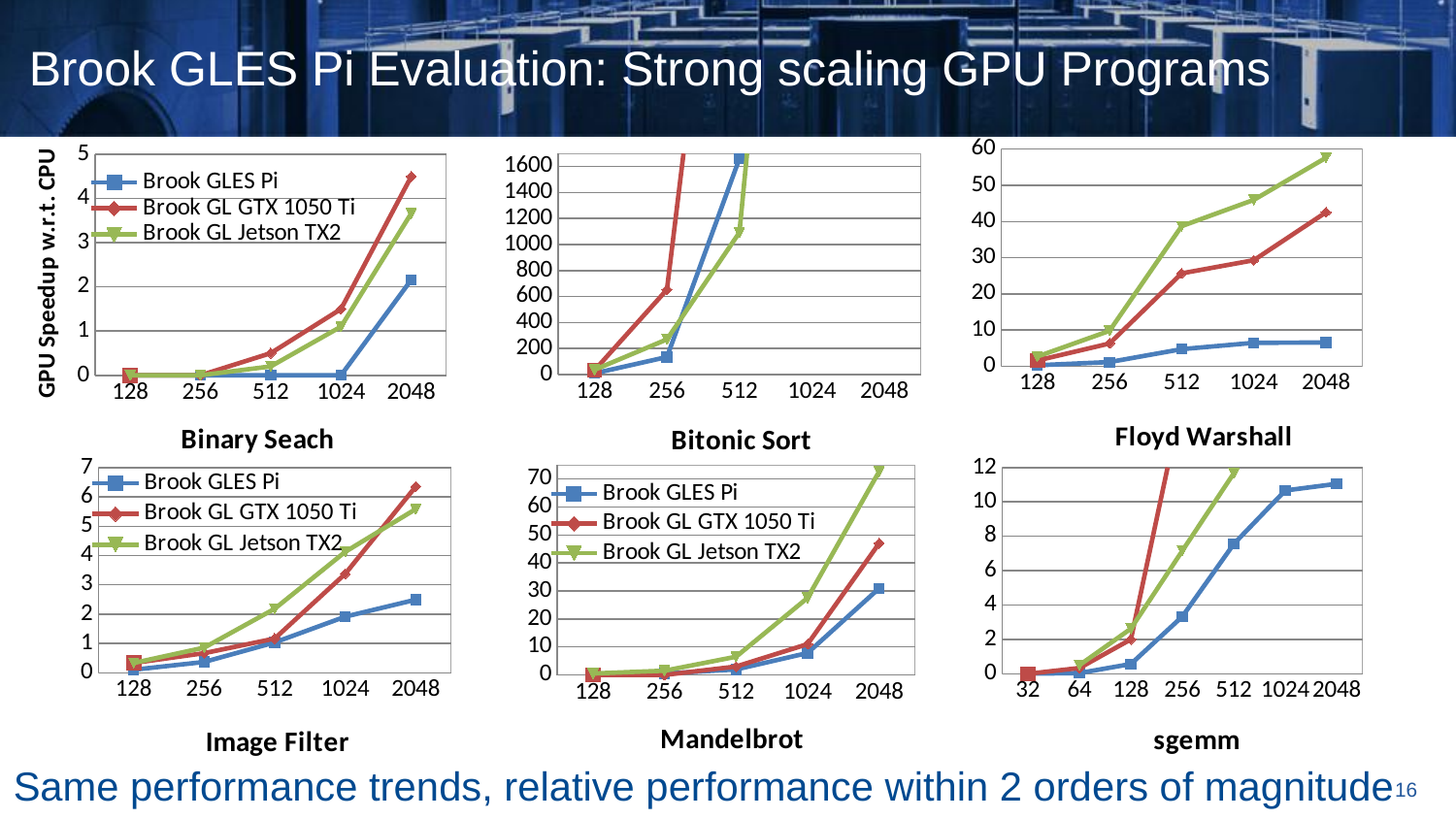
What is the y-axis label of the Binary Seach chart? GPU Speedup w.r.t. CPU In the Binary Seach chart, which is larger at 2048: Brook GL GTX 1050 Ti or Brook GLES Pi? Brook GL GTX 1050 Ti In the Mandelbrot chart, does the Brook GL Jetson TX2 series rise or fall along the x axis? rise In the Floyd Warshall chart, which series has the highest value at 2048? Brook GL Jetson TX2 In the Floyd Warshall chart, which series has the lowest value at 2048? Brook GLES Pi How many x-axis categories does the sgemm chart have? 7 In the Image Filter chart, which is larger at 2048: Brook GL GTX 1050 Ti or Brook GL Jetson TX2? Brook GL GTX 1050 Ti In the Floyd Warshall chart, is the value for Brook GL GTX 1050 Ti at 2048 greater or less than 30? greater In the Image Filter chart, is the value for Brook GLES Pi at 2048 greater or less than 3? less How many x-axis categories does the Binary Seach chart have? 5 How many series does the legend of the Binary Seach chart list? 3 What kind of chart is the Binary Seach chart? line chart